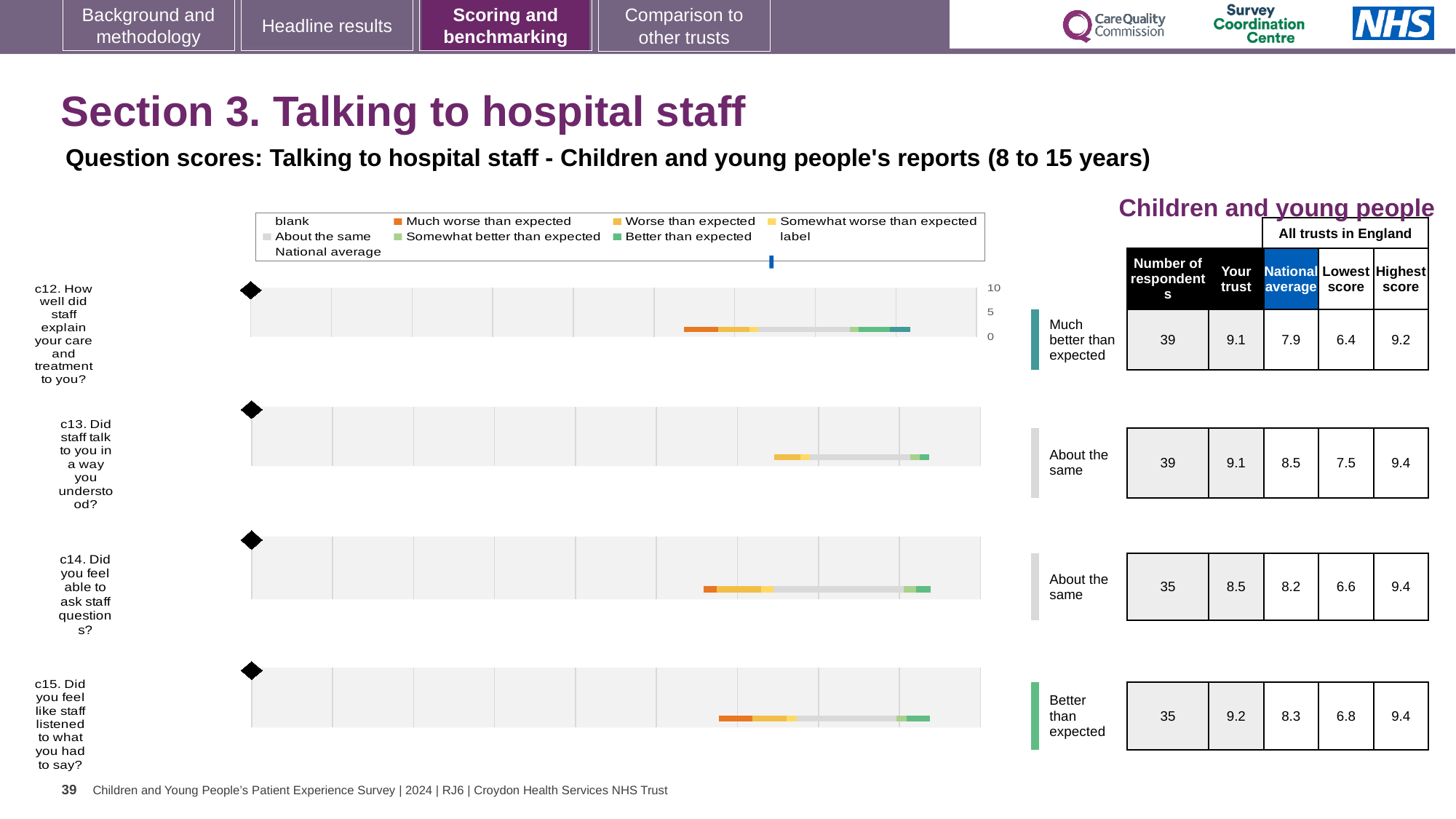
What is the difference between the 'Your trust' score and the national average for c12? 1.2 For c14, which is larger: the 'Your trust' score or the national average? Your trust In the legend, which colour represents 'Much worse than expected'? orange Which question has the highest 'Your trust' score? c15 What is the title of the table to the right of the charts? Children and young people Which rating category is shown for c15 (Did you feel like staff listened to what you had to say?)? Better than expected What is the national average for c15? 8.3 What is the 'Your trust' score for c12? 9.1 How many respondents are listed for c14? 35 How many question charts are shown on the slide? 4 Which rating category is shown for c12 (How well did staff explain your care and treatment to you?)? Much better than expected What kind of chart is used for each question (c12 to c15)? bar chart